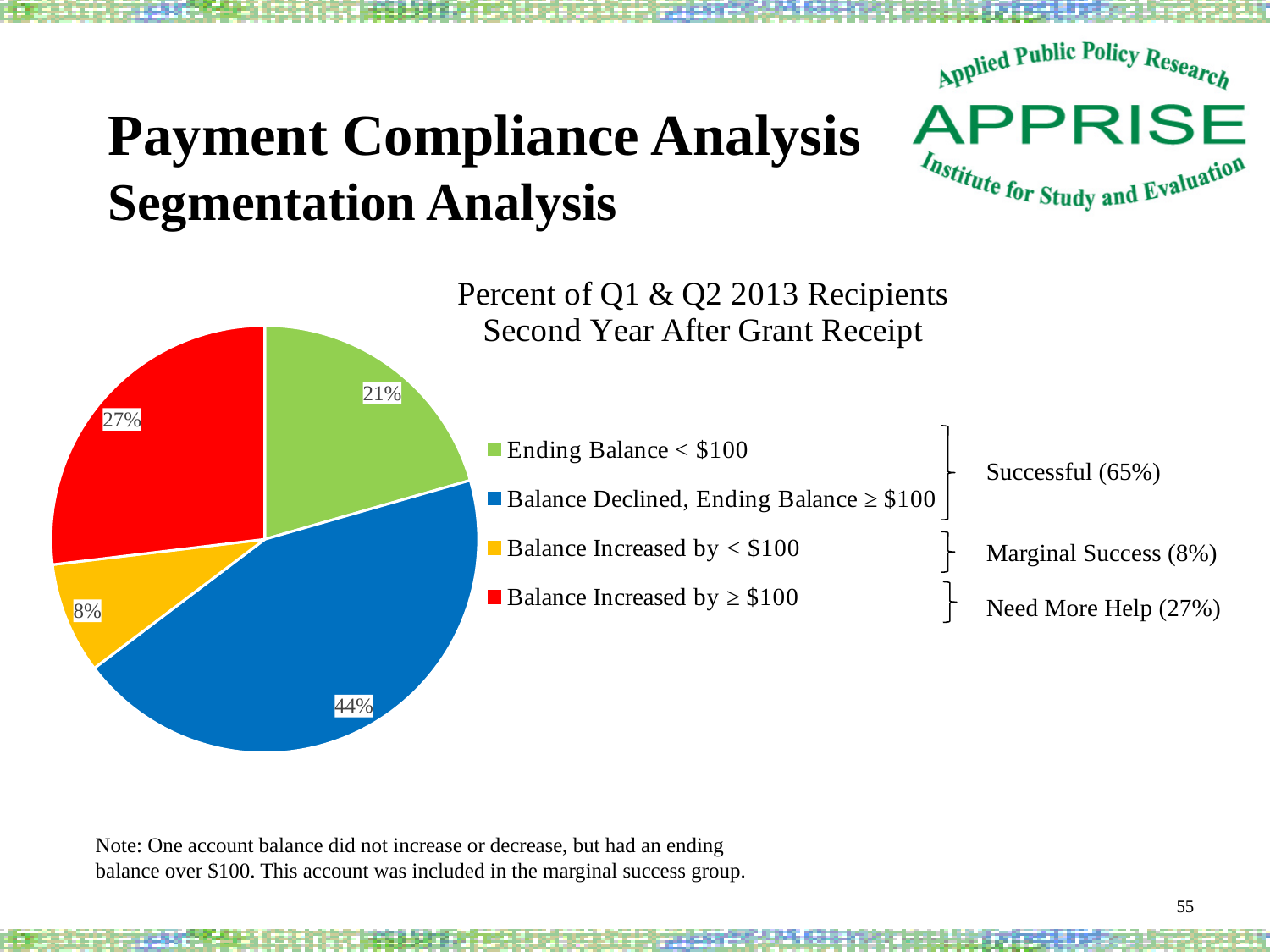
What percentage of recipients had Balance Increased by ≥ $100? 27% Which is larger: the share for Balance Increased by ≥ $100 or the share for Ending Balance < $100? Balance Increased by ≥ $100 Which category has the largest share of the pie? Balance Declined, Ending Balance ≥ $100 What is the difference in percentage points between the Balance Declined, Ending Balance ≥ $100 slice and the Ending Balance < $100 slice? 23 What percentage of recipients had Balance Declined, Ending Balance ≥ $100? 44% What type of chart is shown on the slide? pie chart What percentage of recipients had an Ending Balance < $100? 21% How many slices does the pie chart have? 4 Which category has the smallest share of the pie? Balance Increased by < $100 What percentage of recipients had Balance Increased by < $100? 8% What is the chart's title? Percent of Q1 & Q2 2013 Recipients Second Year After Grant Receipt What colour is the slice for Balance Increased by ≥ $100? red